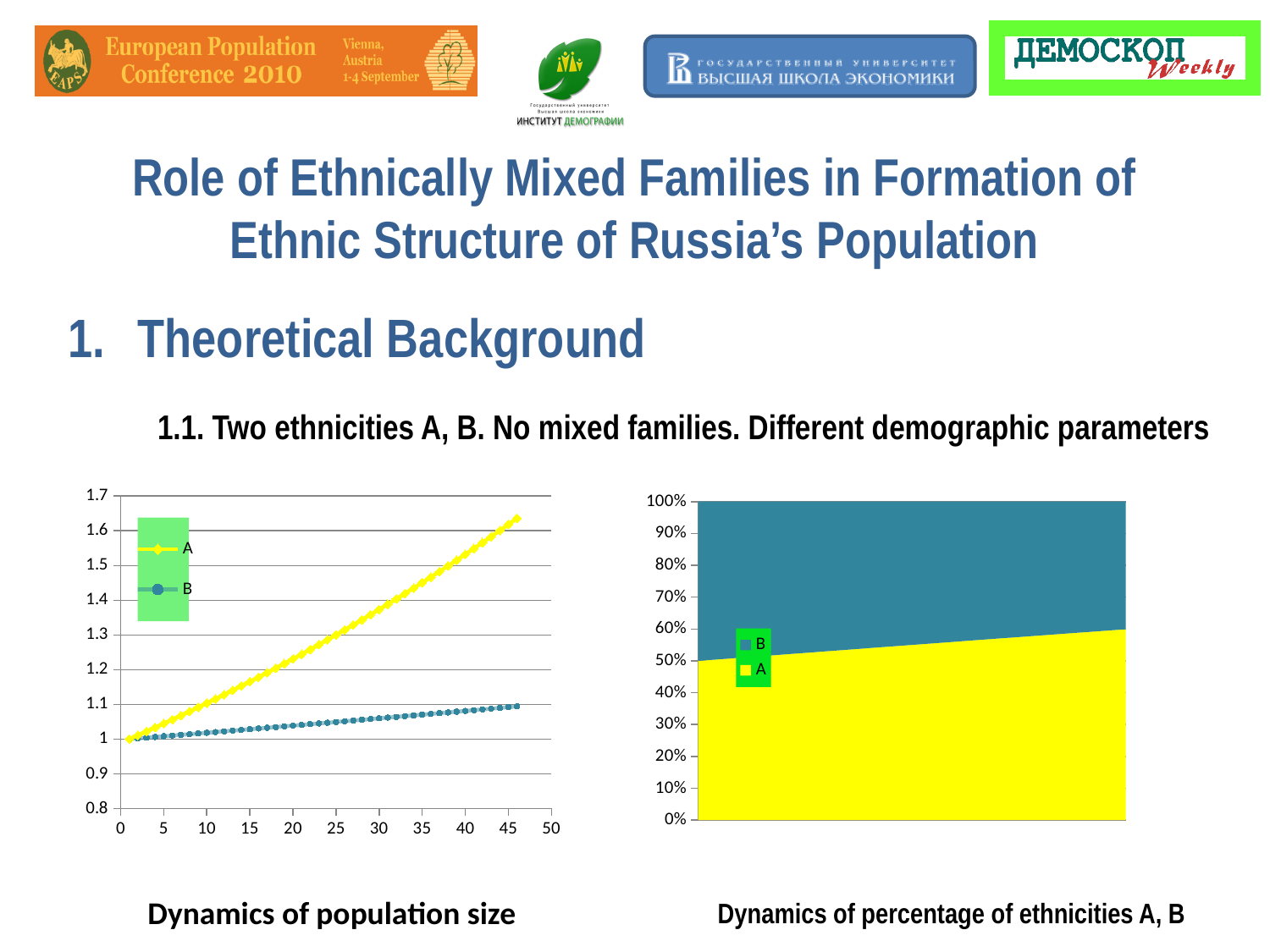
In the 'Dynamics of population size' chart, does series A rise or fall along the x axis? rise In the 'Dynamics of percentage of ethnicities A, B' chart, is the share of A at the right end of the chart greater or less than 50%? greater In the 'Dynamics of population size' chart, which series is higher at x = 40, A or B? A In the 'Dynamics of population size' chart, which series grows faster, A or B? A In the 'Dynamics of population size' chart, is the value of series A at x = 30 greater or less than 1.3? greater What kind of chart is the 'Dynamics of population size' chart on the left? line chart In the 'Dynamics of percentage of ethnicities A, B' chart, which colour represents ethnicity A? yellow How many series does the legend of the 'Dynamics of percentage of ethnicities A, B' chart list? 2 How many series does the legend of the 'Dynamics of population size' chart list? 2 What kind of chart is the 'Dynamics of percentage of ethnicities A, B' chart on the right? stacked area chart In the 'Dynamics of percentage of ethnicities A, B' chart, does the share of A rise or fall along the x axis? rise In the 'Dynamics of population size' chart, is the value of series B at x = 45 greater or less than 1.2? less